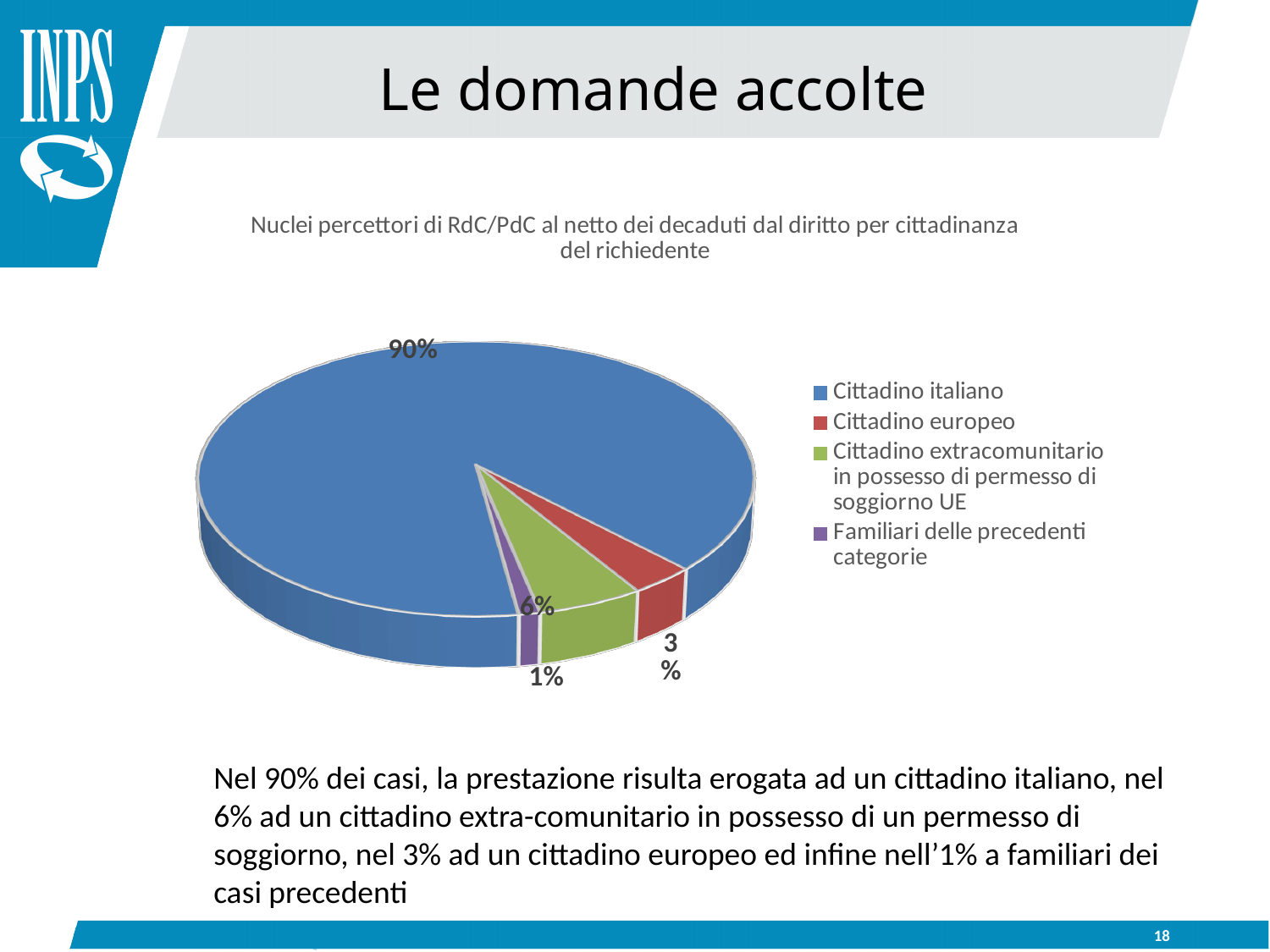
What share of the pie does "Familiari delle precedenti categorie" represent? 1% What share of the pie does "Cittadino extracomunitario in possesso di permesso di soggiorno UE" represent? 6% What is the title of the chart? Nuclei percettori di RdC/PdC al netto dei decaduti dal diritto per cittadinanza del richiedente What share of the pie does "Cittadino europeo" represent? 3% Which is larger: the slice for "Cittadino europeo" or the slice for "Cittadino extracomunitario in possesso di permesso di soggiorno UE"? Cittadino extracomunitario in possesso di permesso di soggiorno UE Which category has the largest slice of the pie? Cittadino italiano What is the difference in percentage points between the "Cittadino italiano" slice and the "Cittadino extracomunitario in possesso di permesso di soggiorno UE" slice? 84 percentage points Which category has the smallest slice of the pie? Familiari delle precedenti categorie How many categories does the pie chart show? 4 What kind of chart is shown on the slide? Pie chart What colour is the slice for "Cittadino europeo"? Red